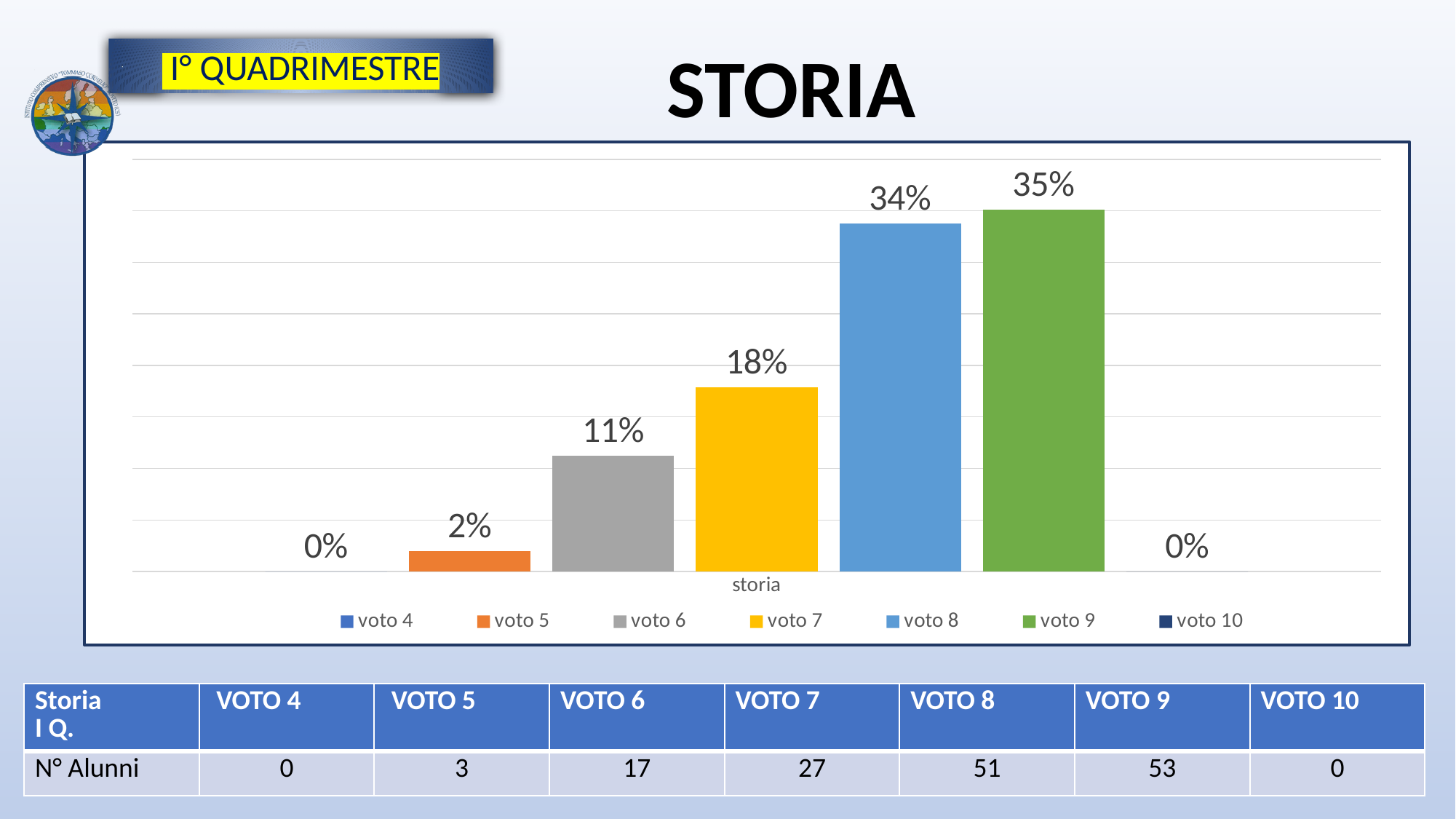
Which series has the highest percentage in the chart? voto 9 What percentage is shown for voto 6 in the chart? 11% What is the difference in percentage points between voto 9 and voto 8? 1% What percentage is shown for voto 7 in the chart? 18% What is the category label shown on the x axis of the chart? storia What kind of chart is shown on the slide? bar chart What percentage is shown for voto 5 in the chart? 2% What percentage is shown for voto 8 in the chart? 34% Which is larger, the percentage for voto 7 or for voto 6? voto 7 How many series does the legend list? 7 What colour is the bar for voto 9 in the chart? green What is the difference in percentage points between voto 7 and voto 6? 7%